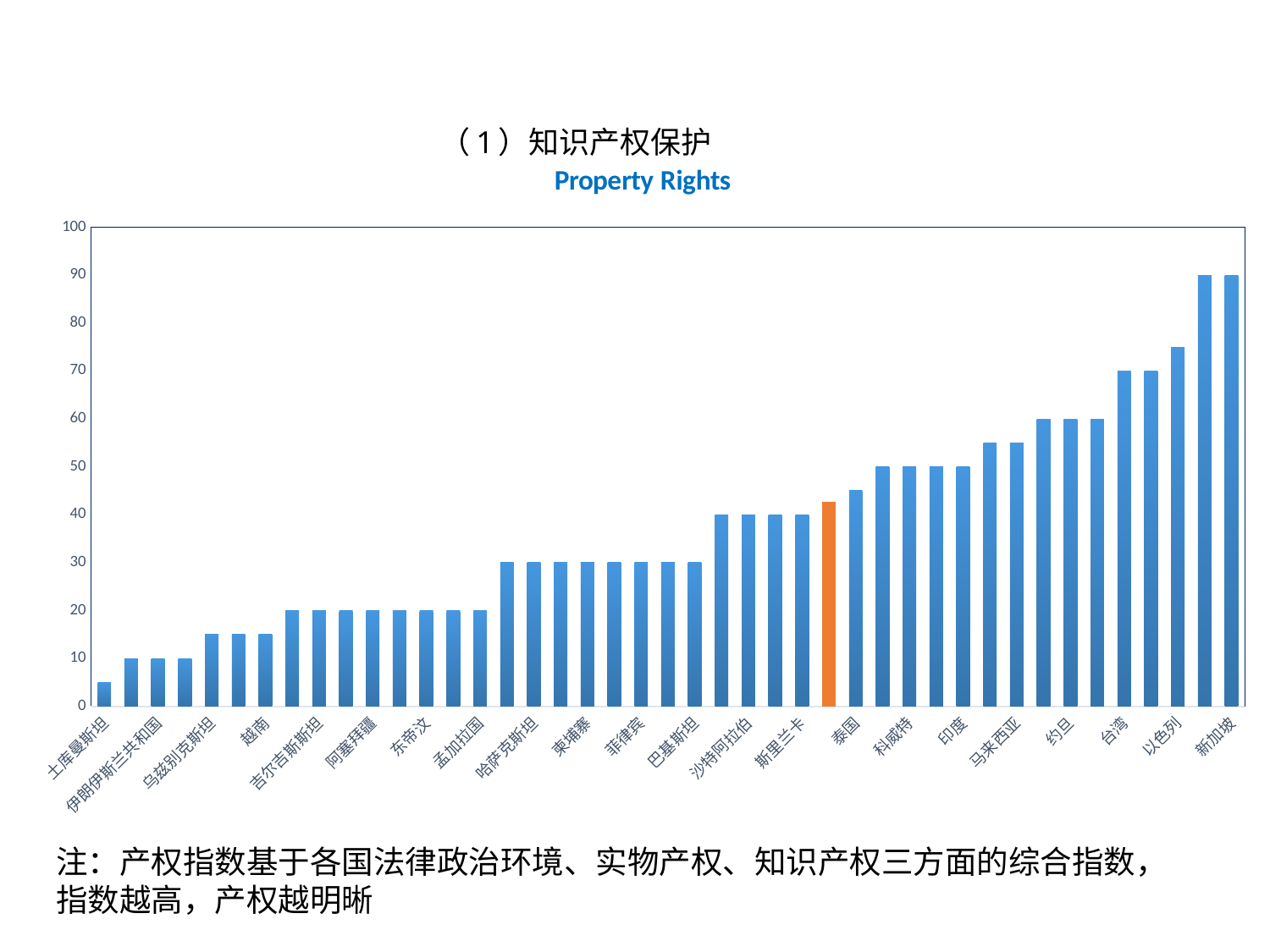
Is the value for 新加坡 greater or less than 80? greater Is the value for 马来西亚 greater or less than 50? greater Which has the larger value, 台湾 or 印度? 台湾 Is the value for 泰国 greater or less than 50? less What is the title of the chart? Property Rights Which has the larger value, 越南 or 哈萨克斯坦? 哈萨克斯坦 What kind of chart is shown on the slide? bar chart Which category has the lowest value in the chart? 土库曼斯坦 What colour is the single highlighted bar that differs from the others? orange Do the values rise or fall from left to right along the x axis? rise